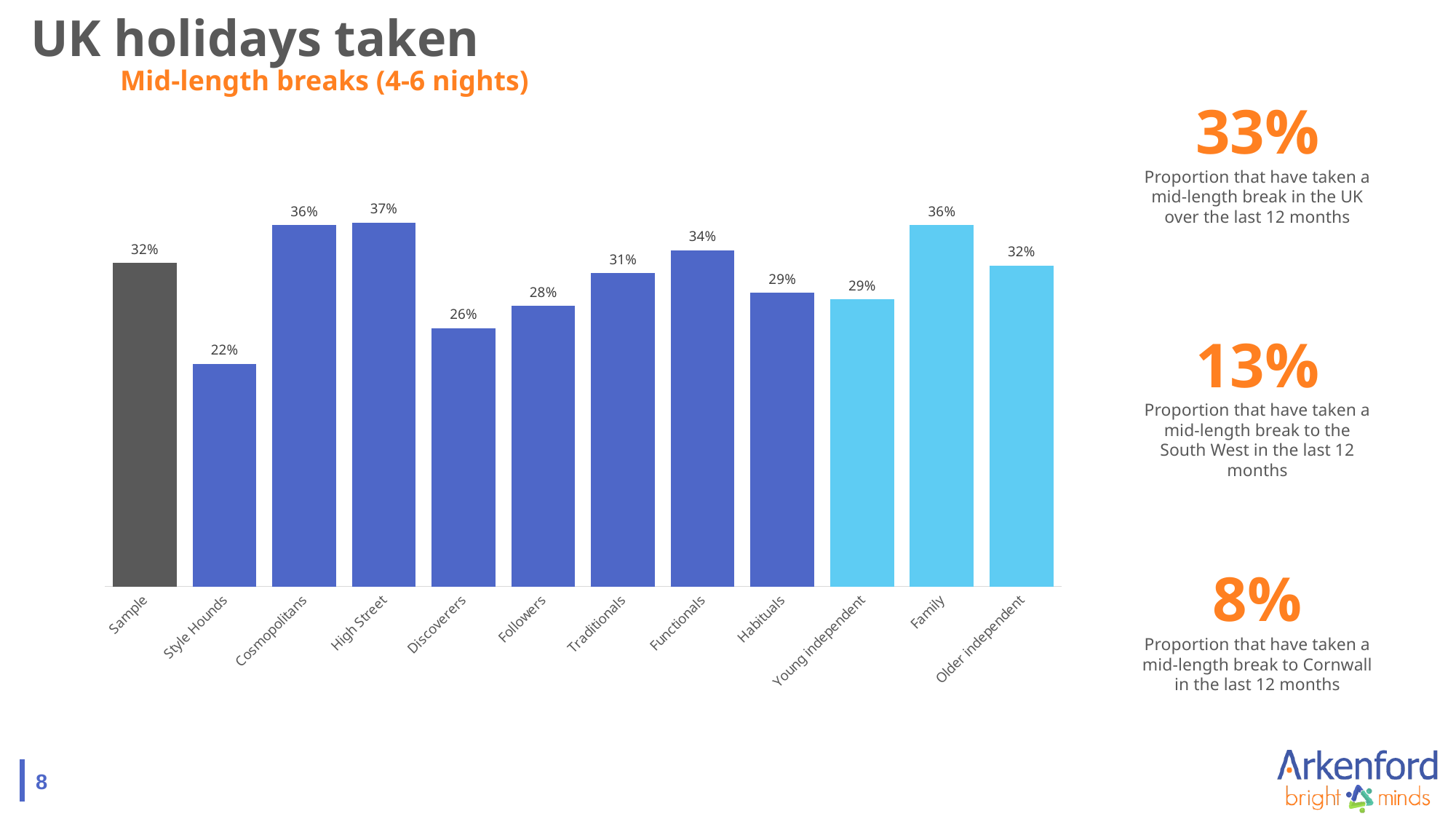
What is the subtitle shown above the chart? Mid-length breaks (4-6 nights) What is the value for the Sample bar? 32% Which category has the lowest value? Style Hounds How many categories are shown on the x axis? 12 Which category has the highest value? High Street What is the value for Young independent? 29% What is the value for Cosmopolitans? 36% Which is larger, the value for Functionals or the value for Traditionals? Functionals What kind of chart is shown on the slide? Bar chart What is the difference between the values for High Street and Discoverers? 11% What is the value for Style Hounds? 22% What is the difference between the values for Family and Older independent? 4%